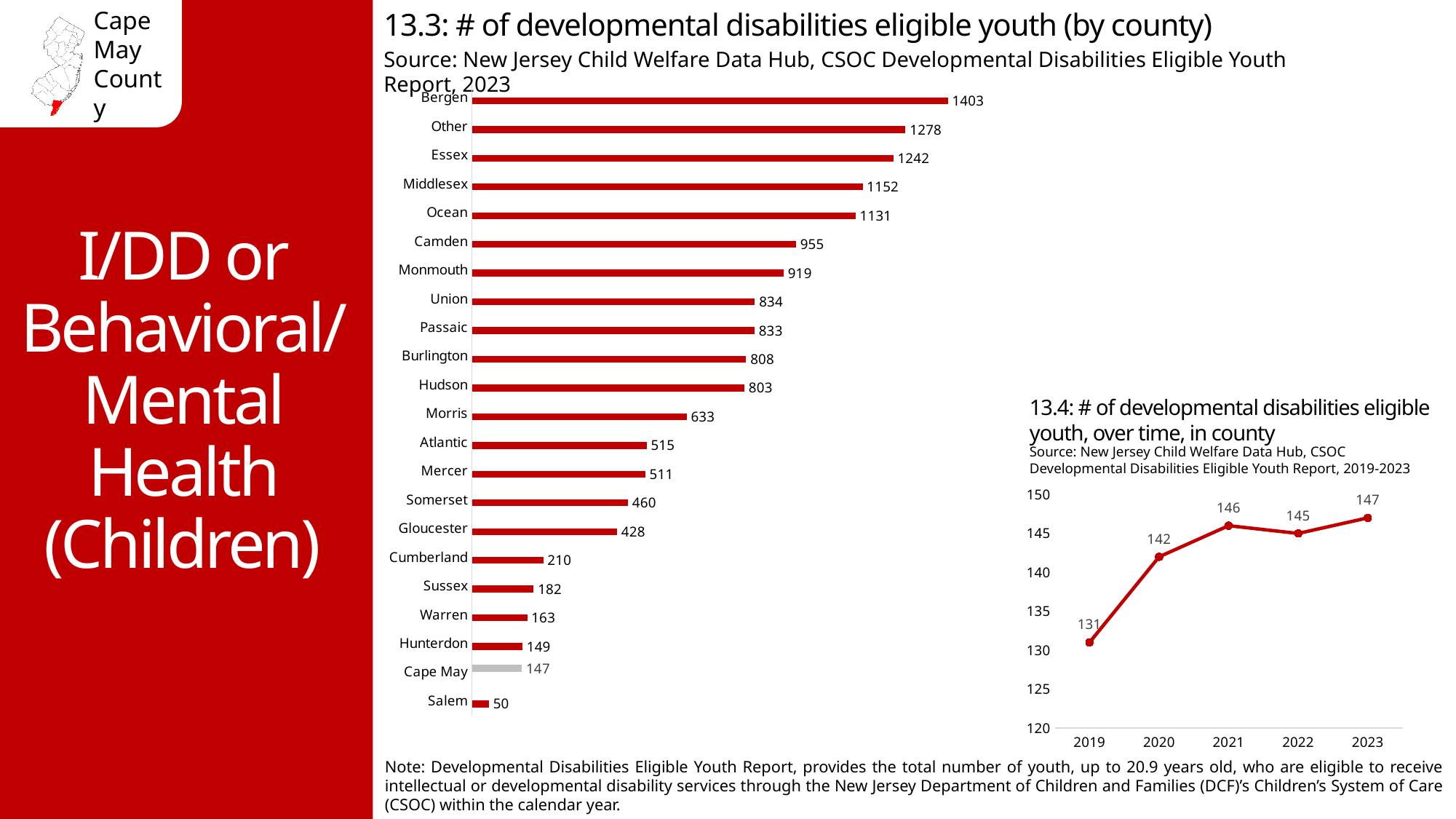
In chart 13.3 (by county), which category has the highest value? Bergen In chart 13.3 (by county), which is larger, Camden or Monmouth? Camden What kind of chart is chart 13.3 (by county)? Bar chart What kind of chart is chart 13.4 (over time, in county)? Line chart In chart 13.4 (over time, in county), which year has the lowest value? 2019 In chart 13.3 (by county), what is the value for Cape May? 147 In chart 13.4 (over time, in county), what is the value for 2021? 146 In chart 13.3 (by county), how many categories are shown? 22 In chart 13.3 (by county), what is the difference between Essex and Middlesex? 90 In chart 13.4 (over time, in county), what is the difference between 2023 and 2019? 16 In chart 13.3 (# of developmental disabilities eligible youth by county), what is the value for Bergen? 1403 In chart 13.3 (by county), which county has the lowest value? Salem